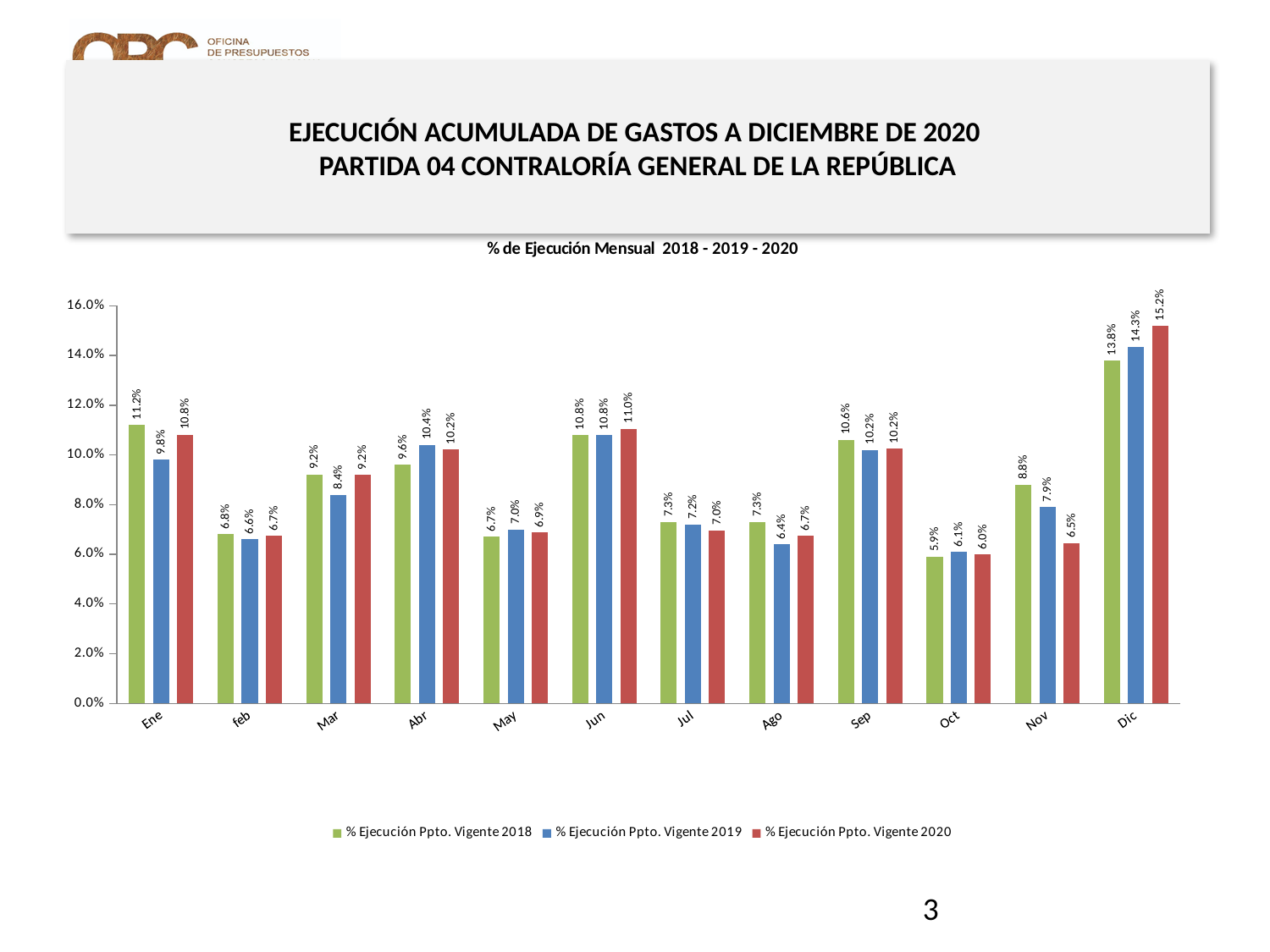
How many months are shown on the x axis? 12 What is the value for % Ejecución Ppto. Vigente 2020 in Dic? 15.2% What is the difference between the % Ejecución Ppto. Vigente 2020 value in Dic and in Nov? 8.7% Which month has the highest value for % Ejecución Ppto. Vigente 2019? Dic Which month has the lowest value for % Ejecución Ppto. Vigente 2018? Oct Which is larger in Nov: the value for % Ejecución Ppto. Vigente 2018 or for % Ejecución Ppto. Vigente 2020? % Ejecución Ppto. Vigente 2018 How many series does the legend list? 3 What kind of chart is shown on the slide? Bar chart What is the value for % Ejecución Ppto. Vigente 2018 in Ene? 11.2% Is the value for % Ejecución Ppto. Vigente 2019 in Dic greater or less than 14.0%? greater What is the title of the chart? % de Ejecución Mensual 2018 - 2019 - 2020 What is the value for % Ejecución Ppto. Vigente 2019 in Abr? 10.4%